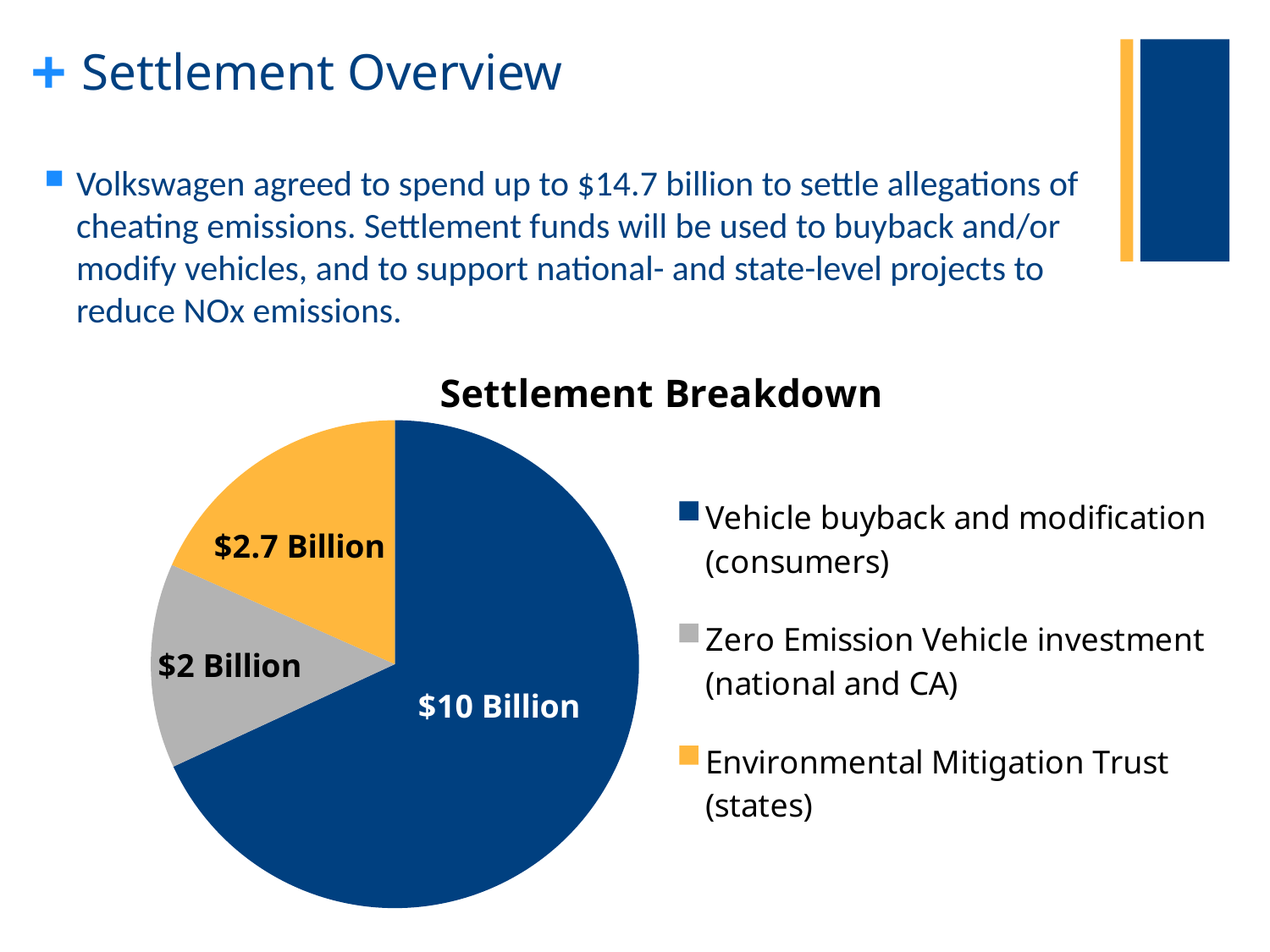
In the Settlement Breakdown chart, what is the difference between the Environmental Mitigation Trust slice and the Zero Emission Vehicle investment slice? $0.7 Billion In the Settlement Breakdown chart, which is larger: Environmental Mitigation Trust (states) or Zero Emission Vehicle investment (national and CA)? Environmental Mitigation Trust (states) Which category has the smallest slice in the Settlement Breakdown chart? Zero Emission Vehicle investment (national and CA) In the Settlement Breakdown chart, what colour is the Environmental Mitigation Trust (states) slice? Yellow/orange In the Settlement Breakdown chart, how much larger is the Vehicle buyback and modification slice than the Environmental Mitigation Trust slice? $7.3 Billion In the Settlement Breakdown chart, what is the total of all three slices? $14.7 Billion In the Settlement Breakdown chart, what is the value for Zero Emission Vehicle investment (national and CA)? $2 Billion In the Settlement Breakdown chart, what is the value for Vehicle buyback and modification (consumers)? $10 Billion Which category has the largest slice in the Settlement Breakdown chart? Vehicle buyback and modification (consumers) What kind of chart is the Settlement Breakdown chart? Pie chart In the Settlement Breakdown chart, what is the value for Environmental Mitigation Trust (states)? $2.7 Billion How many slices does the Settlement Breakdown pie chart have? 3